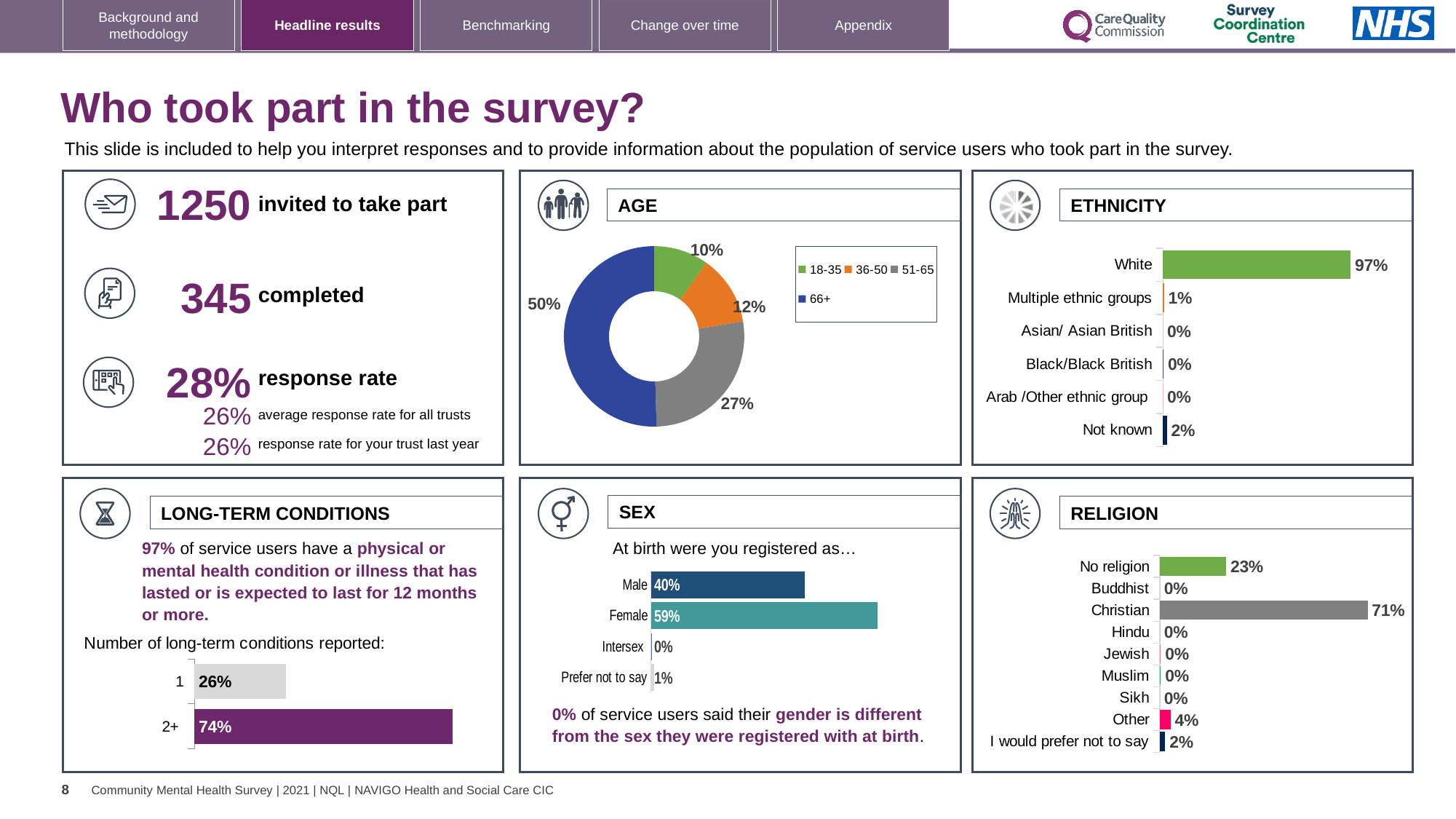
In the RELIGION chart, which category has the highest value? Christian In the ETHNICITY chart, what is the value for White? 97% What kind of chart is the AGE chart? Donut chart In the AGE chart, which age group has the smallest share? 18-35 How many categories does the ETHNICITY chart show? 6 How many entries does the legend of the AGE chart list? 4 In the RELIGION chart, what is the value for Other? 4% In the SEX chart, what is the value for Prefer not to say? 1% In the AGE chart, what share of respondents are aged 66+? 50% In the SEX chart, which is larger, the value for Male or the value for Female? Female In the LONG-TERM CONDITIONS chart, what is the difference between the value for 2+ and the value for 1? 48% In the ETHNICITY chart, what is the value for Not known? 2%